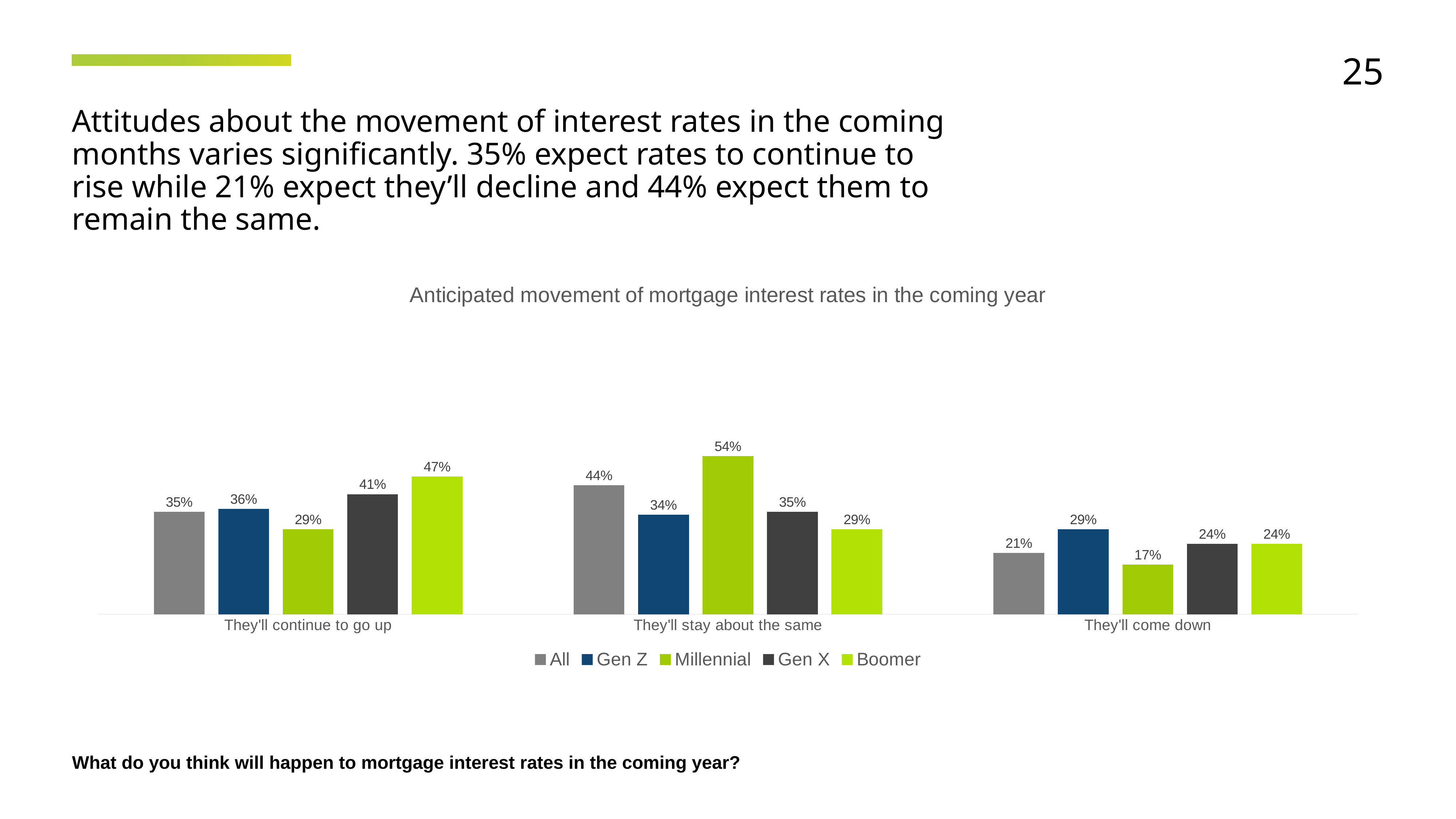
What is the title of the chart? Anticipated movement of mortgage interest rates in the coming year What is the value for Gen Z in the "They'll come down" category? 29% Which series has the highest value in the "They'll continue to go up" category? Boomer How many categories are shown on the x axis? 3 What is the value for Millennial in the "They'll stay about the same" category? 54% Which is larger in the "They'll continue to go up" category: Gen X or Millennial? Gen X Which series has the lowest value in the "They'll come down" category? Millennial What kind of chart is shown on the slide? Bar chart What is the difference between the Millennial and Gen Z values in the "They'll stay about the same" category? 20% How many series does the legend list? 5 What is the value for Boomer in the "They'll continue to go up" category? 47% What is the difference between the All values for "They'll stay about the same" and "They'll come down"? 23%